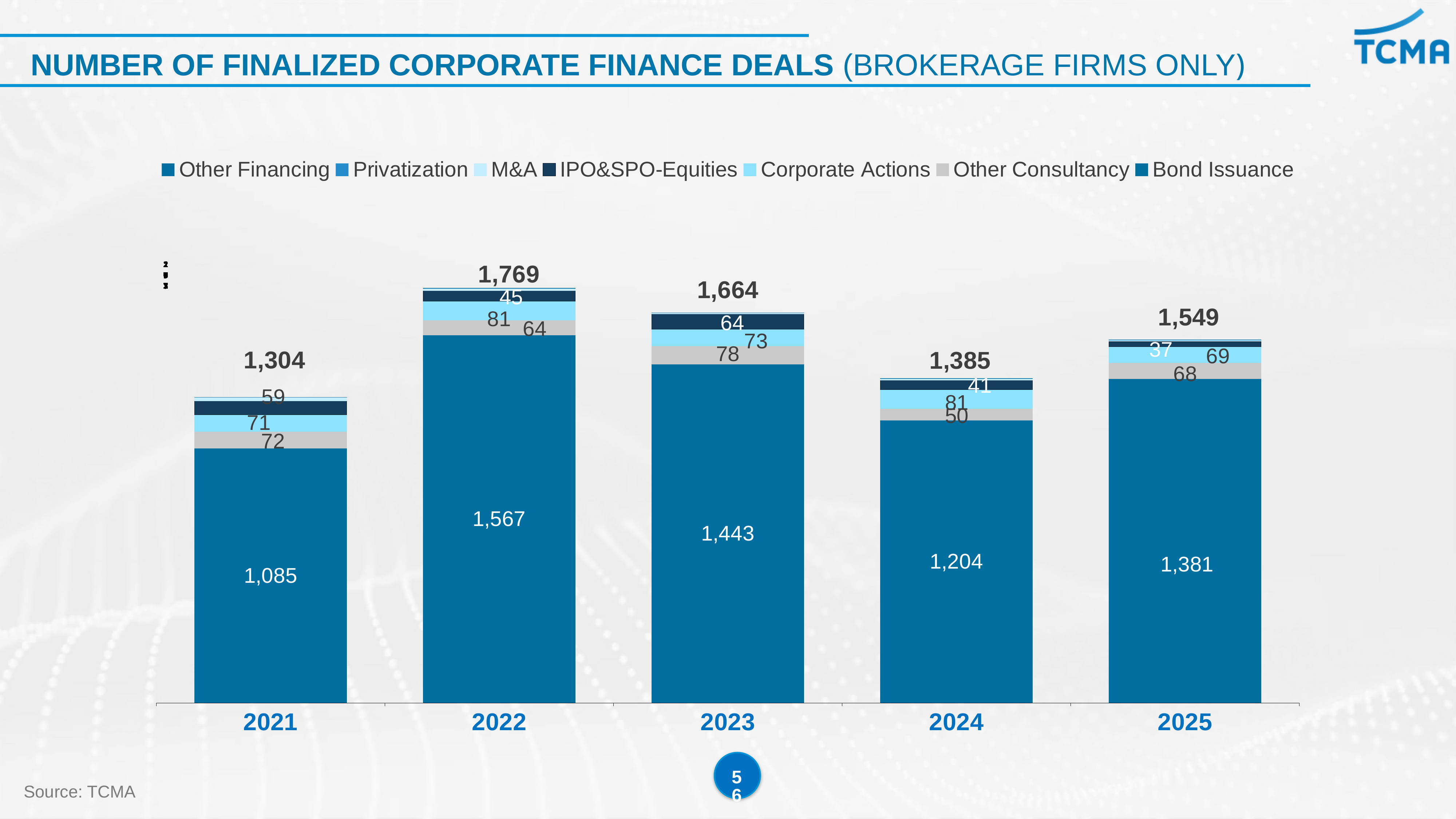
Which year has the larger total, 2024 or 2025? 2025 What is the difference between the Other Consultancy values for 2023 and 2024? 28 What is the difference between the total for 2022 and the total for 2023? 105 What is the value of the IPO&SPO-Equities segment in 2025? 37 How many years are shown on the x axis? 5 What is the total number of finalized corporate finance deals shown for 2022? 1,769 How many series does the legend list? 7 Which year has the lowest total number of deals? 2021 What kind of chart is shown on the slide? Stacked bar chart Which year has the highest total number of deals? 2022 What is the value of the largest (bottom) segment of the 2021 bar? 1,085 What is the value of the Other Consultancy segment in 2023? 78